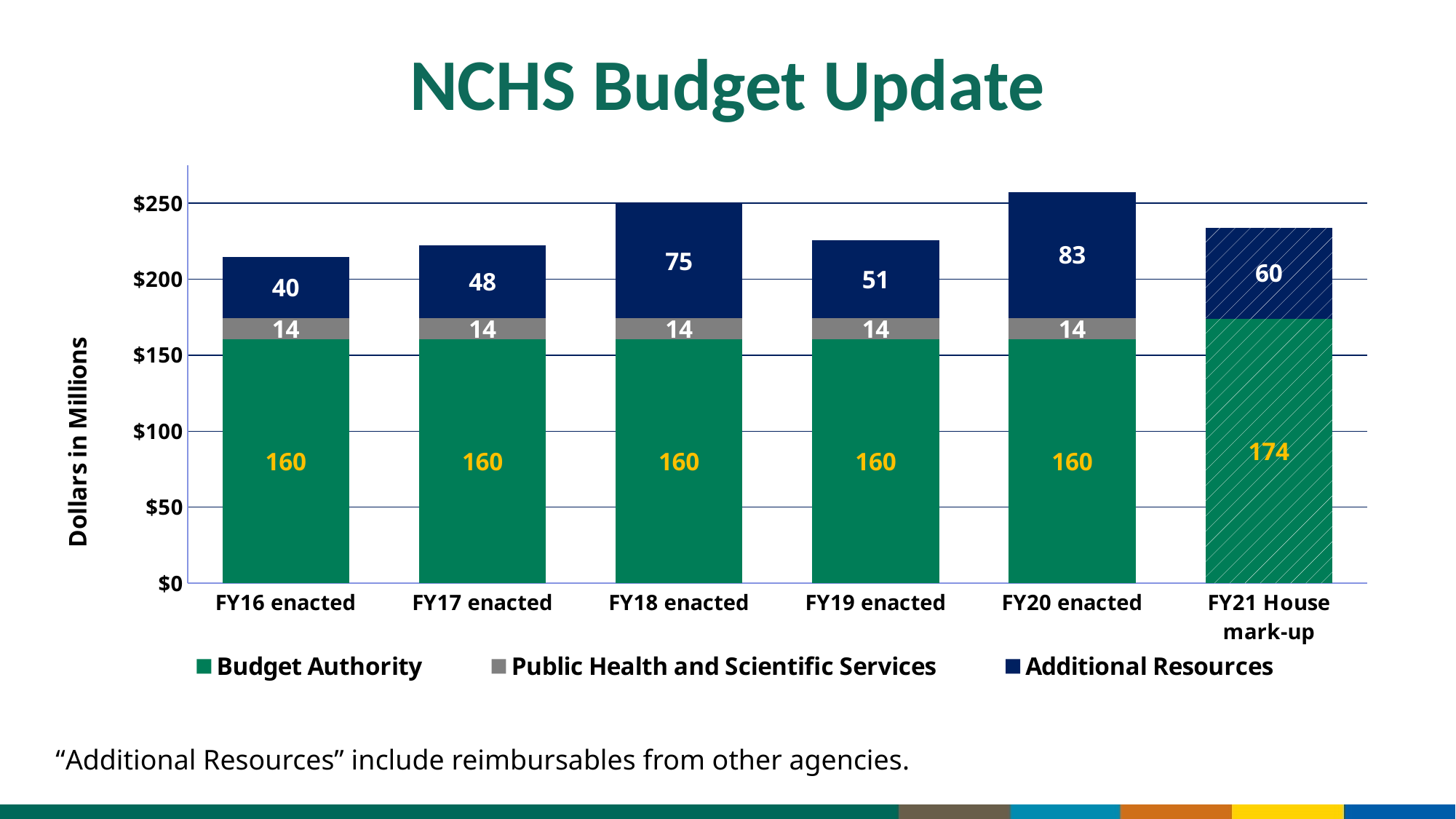
Which category has the highest Additional Resources value? FY20 enacted What type of chart is shown on the slide? Stacked bar chart What is the Budget Authority value for FY21 House mark-up? 174 How many series does the legend list? 3 What is the Public Health and Scientific Services value for FY19 enacted? 14 What is the difference between the Additional Resources values for FY20 enacted and FY16 enacted? 43 Is the Additional Resources value larger for FY17 enacted or FY19 enacted? FY19 enacted What is the title of the chart? NCHS Budget Update Which category has the lowest Additional Resources value? FY16 enacted How many fiscal year categories are shown on the x axis? 6 What is the total of the stacked bar for FY20 enacted? 257 What is the Additional Resources value for FY18 enacted? 75